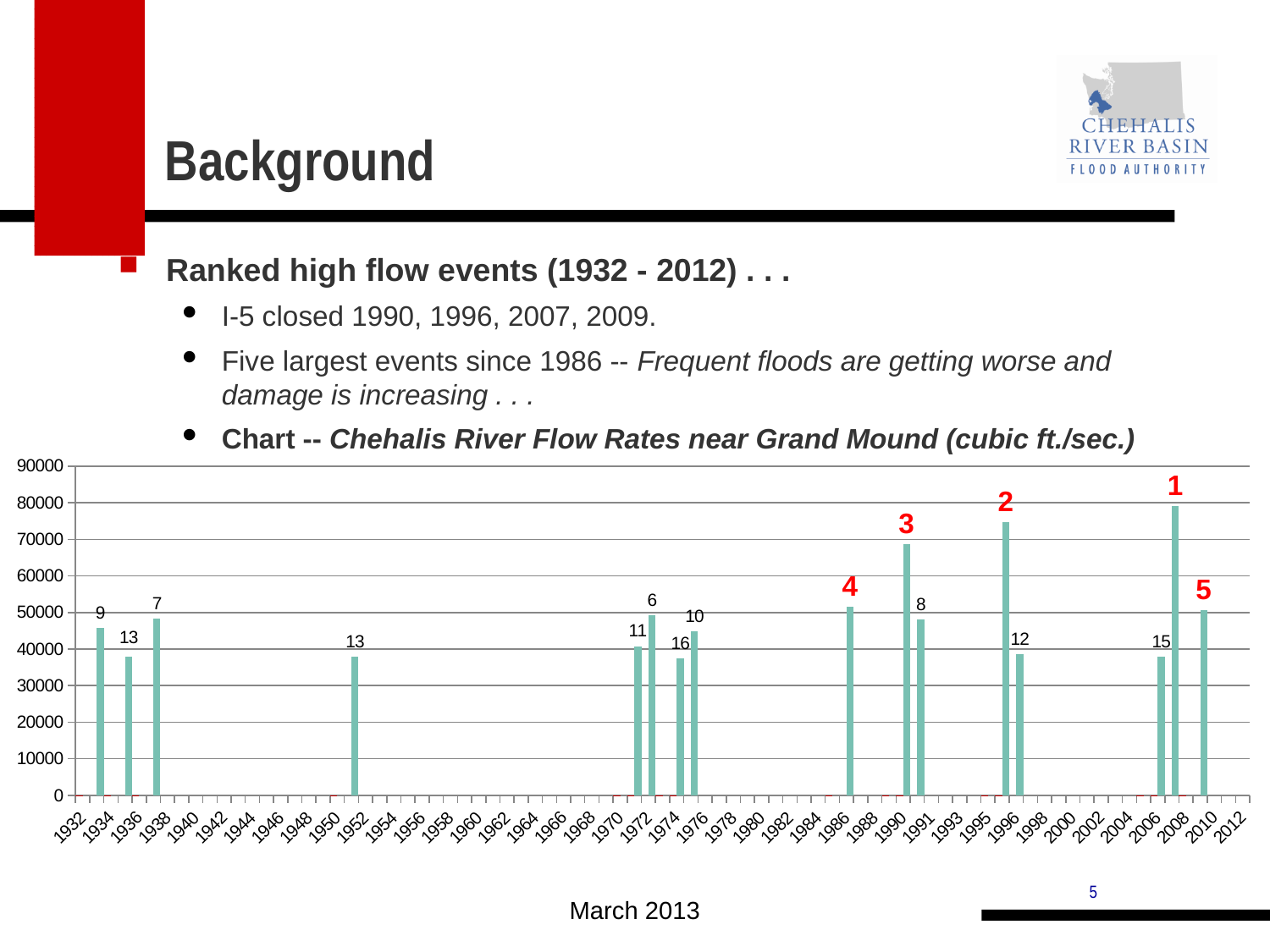
What kind of chart is shown on the slide? bar chart Is the value of the bar labeled 16 greater or less than 40000? less How many bars in the chart have red rank labels? 5 What is the title of the chart on the slide? Chehalis River Flow Rates near Grand Mound (cubic ft./sec.) Which is larger, the bar labeled 2 or the bar labeled 3? the bar labeled 2 Which rank label marks the lowest bar in the chart? 16 Which rank label marks the highest bar in the chart? 1 Is the value of the bar labeled 2 greater or less than 70000? greater How many bars are plotted in the chart? 16 Is the value of the bar labeled 7 greater or less than 50000? less